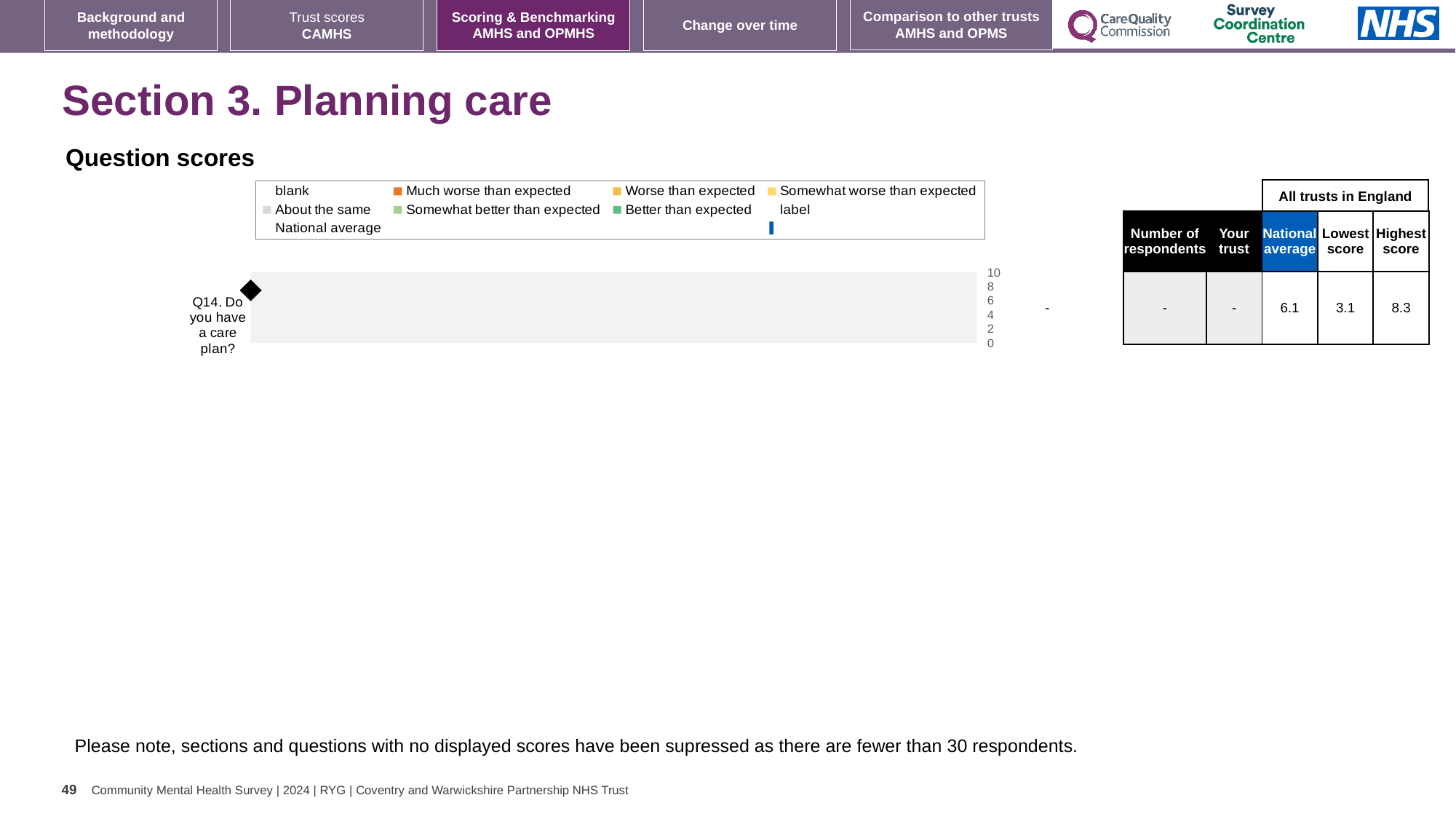
In the table beside the chart, what is shown for Your trust score for Q14? - Which question is labelled on the Question scores chart? Q14. Do you have a care plan? What kind of chart is the Question scores chart? bar chart In the table beside the chart, what is the Highest score for Q14? 8.3 How many question categories are plotted on the Question scores chart? 1 In the table beside the chart, what is the Lowest score for Q14? 3.1 What is the highest tick value shown on the axis of the Question scores chart? 10 In the table beside the chart, what is the National average score for Q14? 6.1 In the table beside the chart, is the National average for Q14 greater or less than 5? greater In the table beside the chart, what is the difference between the Highest score and the Lowest score for Q14? 5.2